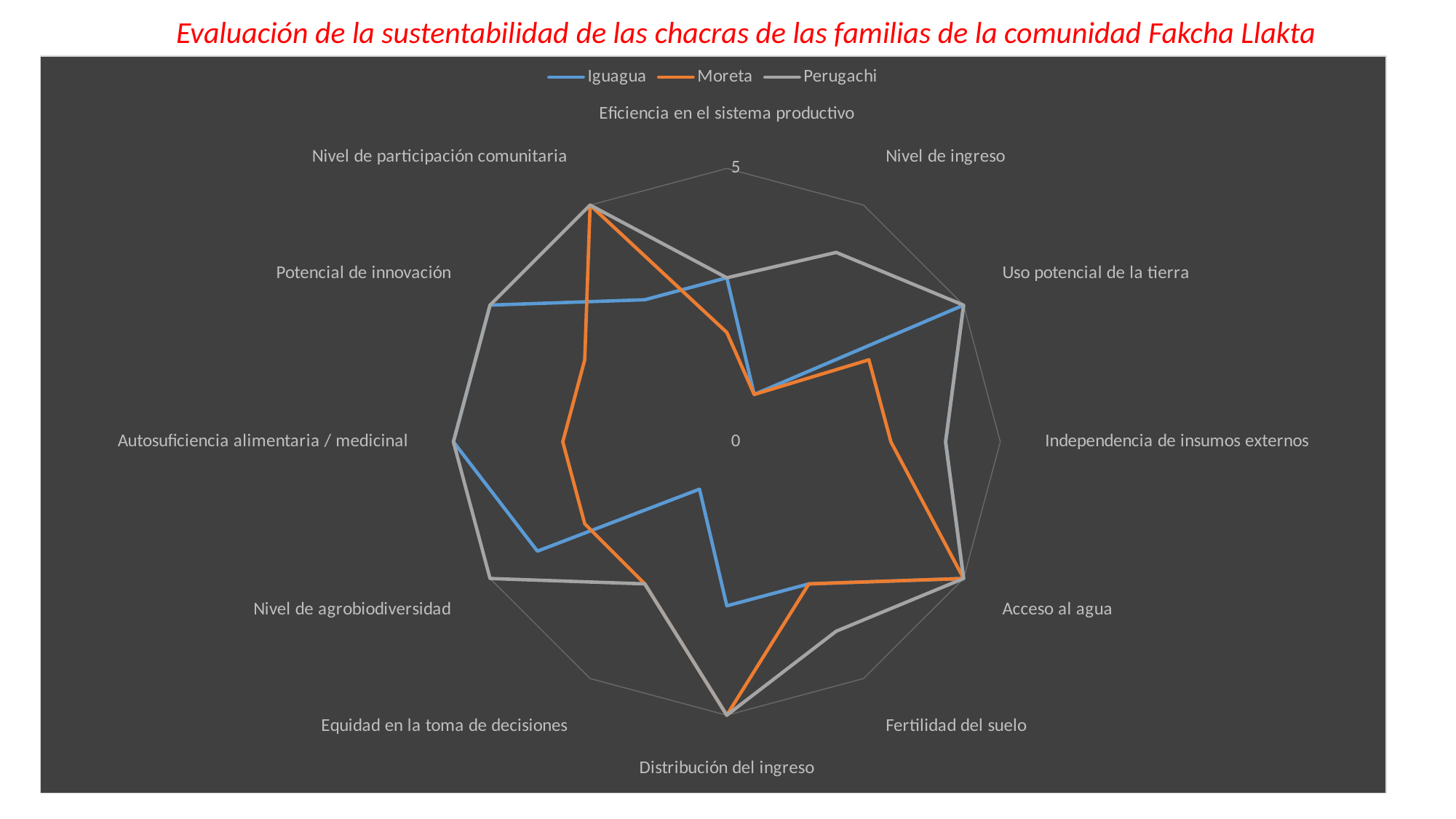
What is the value for Moreta on the Acceso al agua axis? 5 Which series has the highest value on the Potencial de innovación axis? Iguagua and Perugachi (tied at 5) Which series is drawn in orange? Moreta Which series has the lowest value on the Acceso al agua axis? None — all three series are tied at 5 What kind of chart is shown on the slide? Radar chart What is the value for Iguagua on the Autosuficiencia alimentaria / medicinal axis? 5 What is the value for Perugachi on the Uso potencial de la tierra axis? 5 How many categories (axes) does the radar chart have? 12 Which series has the highest value on the Nivel de ingreso axis? Perugachi What is the maximum value shown on the radar chart's scale? 5 On the Uso potencial de la tierra axis, which is larger: Iguagua or Moreta? Iguagua How many series does the legend list? 3